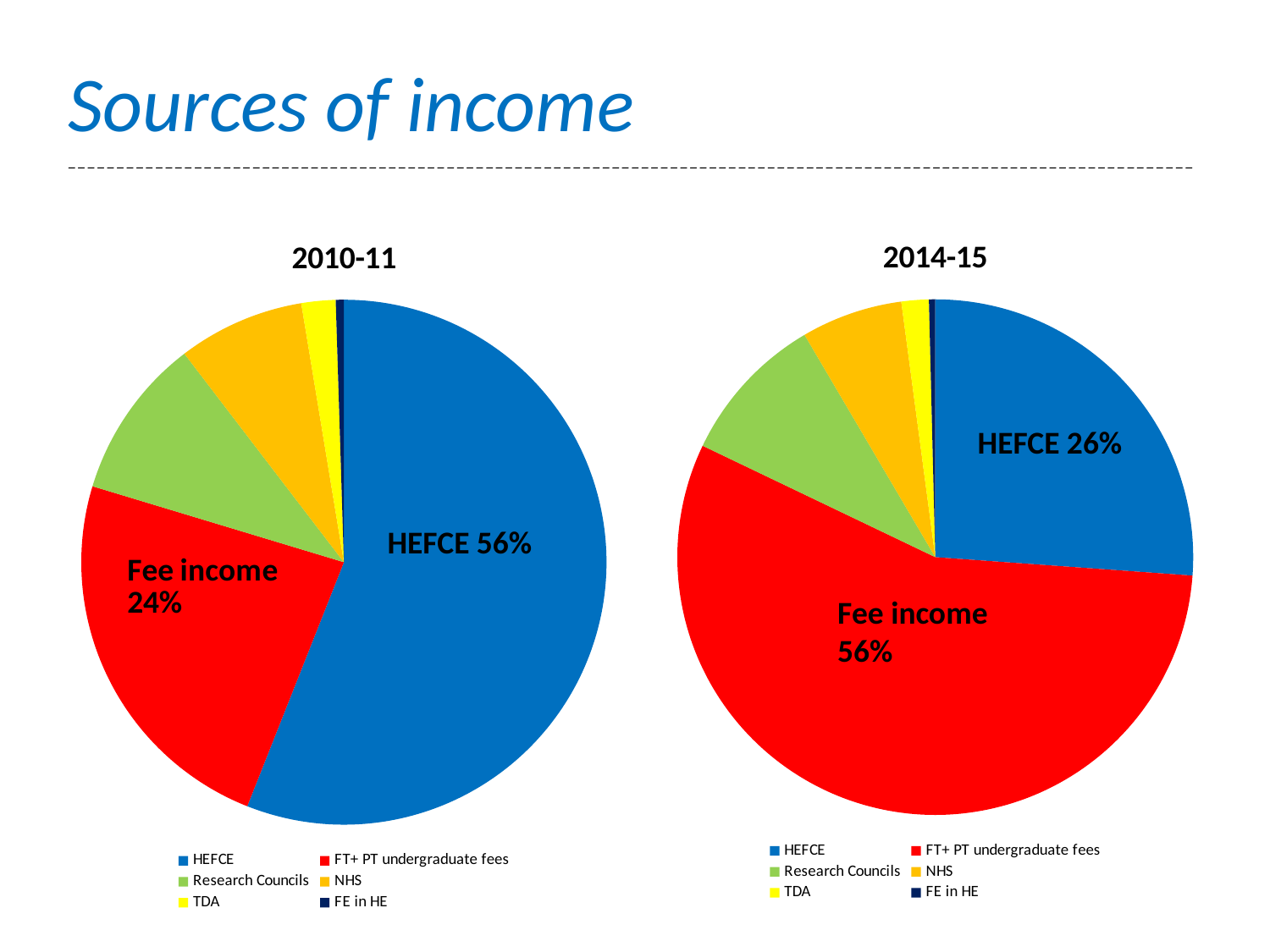
In the 2010-11 pie chart, what share of income comes from HEFCE? 56% In the 2014-15 pie chart, which source of income has the smallest slice? FE in HE How many income sources does the legend of the 2010-11 pie chart list? 6 In the 2014-15 pie chart, what share of income comes from HEFCE? 26% In the 2014-15 pie chart, what is the difference in percentage points between the fee income share and the HEFCE share? 30 percentage points In the 2010-11 pie chart, what share of income is fee income? 24% In the 2010-11 pie chart, which source of income has the largest slice? HEFCE In the 2014-15 pie chart, what share of income is fee income? 56% What type of chart is used to show the 2014-15 sources of income? Pie chart Is the HEFCE share larger in the 2010-11 pie chart or the 2014-15 pie chart? 2010-11 In the 2010-11 pie chart, what is the difference in percentage points between the HEFCE share and the fee income share? 32 percentage points In the 2014-15 pie chart, which source of income has the largest slice? Fee income